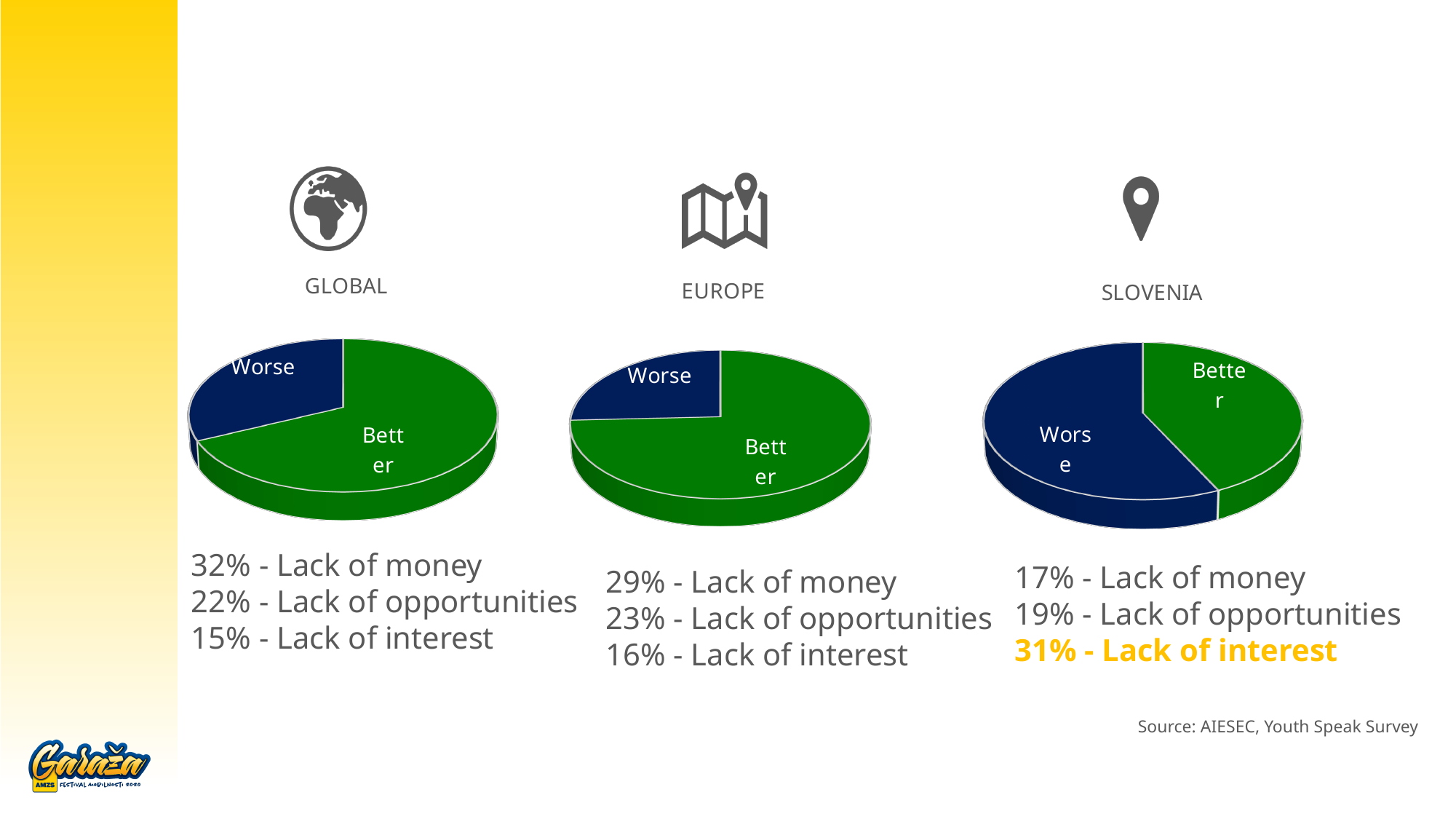
How many slices does the GLOBAL pie chart have? 2 What are the names of the two slices in the SLOVENIA pie chart? Worse and Better How many pie charts are shown on the slide? 3 In the EUROPE pie chart, which slice is the smallest? Worse What colour is the Better slice in the pie charts? Green What kind of chart is used under the GLOBAL heading? Pie chart In the SLOVENIA pie chart, which slice is the smallest? Better What colour is the Worse slice in the pie charts? Dark blue In the GLOBAL pie chart, which slice is larger, Worse or Better? Better Which of the three pie charts is the only one where the Worse slice is larger than the Better slice? SLOVENIA In the EUROPE pie chart, which slice is larger, Worse or Better? Better